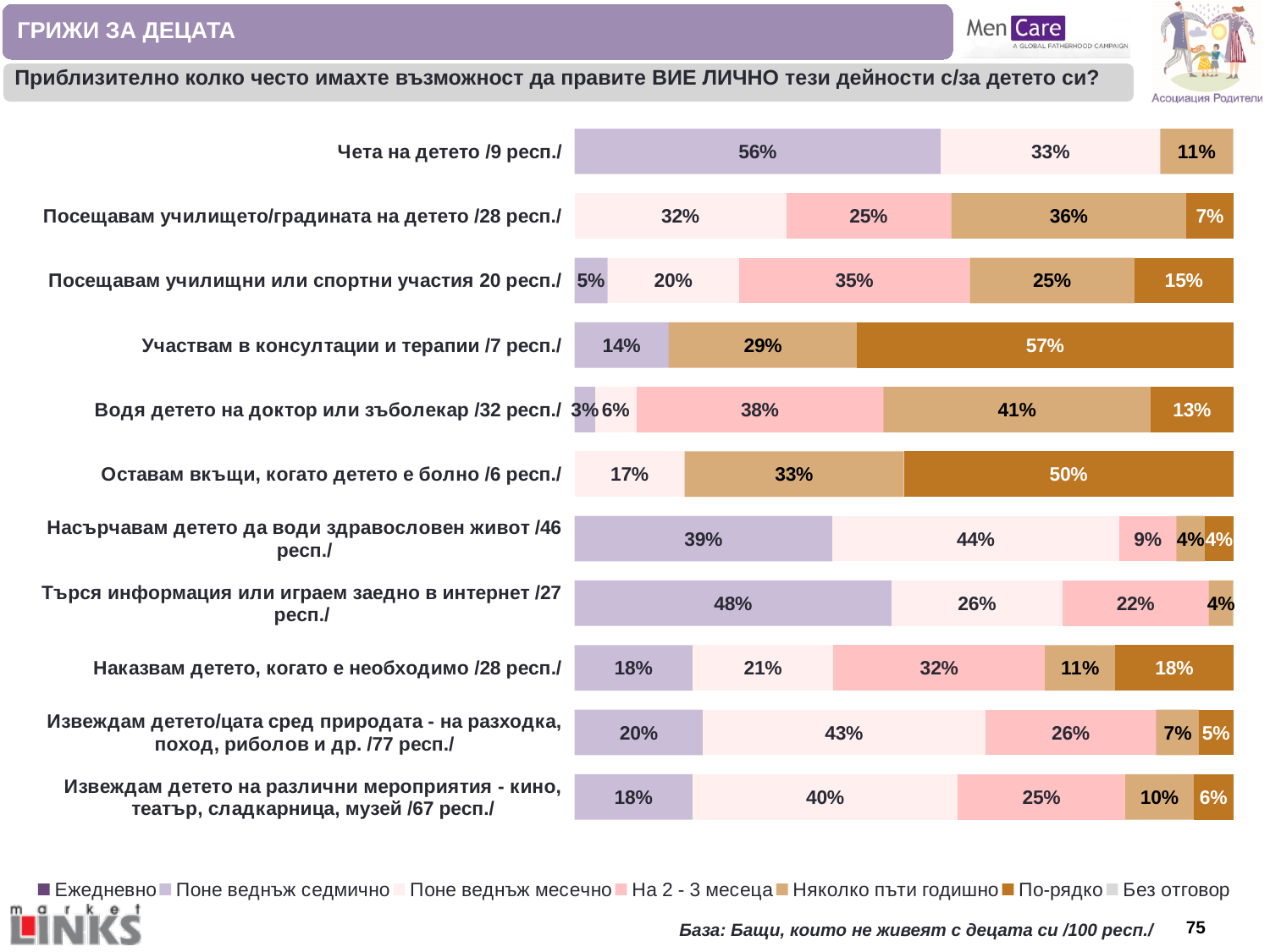
What is the value for "По-рядко" in the "Участвам в консултации и терапии /7 респ./" bar? 57% How many series does the legend list? 7 Which category has the highest value for "Поне веднъж седмично"? Чета на детето /9 респ./ What kind of chart is shown on the slide? Stacked bar chart What is the value for "Поне веднъж месечно" in the "Извеждам детето/цата сред природата - на разходка, поход, риболов и др. /77 респ./" bar? 43% How many activity categories are plotted in the chart? 11 What is the value for "Поне веднъж седмично" in the "Чета на детето /9 респ./" bar? 56% Which is larger: the "На 2 - 3 месеца" value for "Посещавам училищни или спортни участия 20 респ./" or for "Наказвам детето, когато е необходимо /28 респ./"? Посещавам училищни или спортни участия 20 респ./ What is the value for "Няколко пъти годишно" in the "Водя детето на доктор или зъболекар /32 респ./" bar? 41% What is the total of the "Търся информация или играем заедно в интернет /27 респ./" bar? 100% Which category has the lowest value for "Поне веднъж седмично" among those where it is shown? Водя детето на доктор или зъболекар /32 респ./ What is the difference between the "По-рядко" values for "Оставам вкъщи, когато детето е болно /6 респ./" and "Наказвам детето, когато е необходимо /28 респ./"? 32%